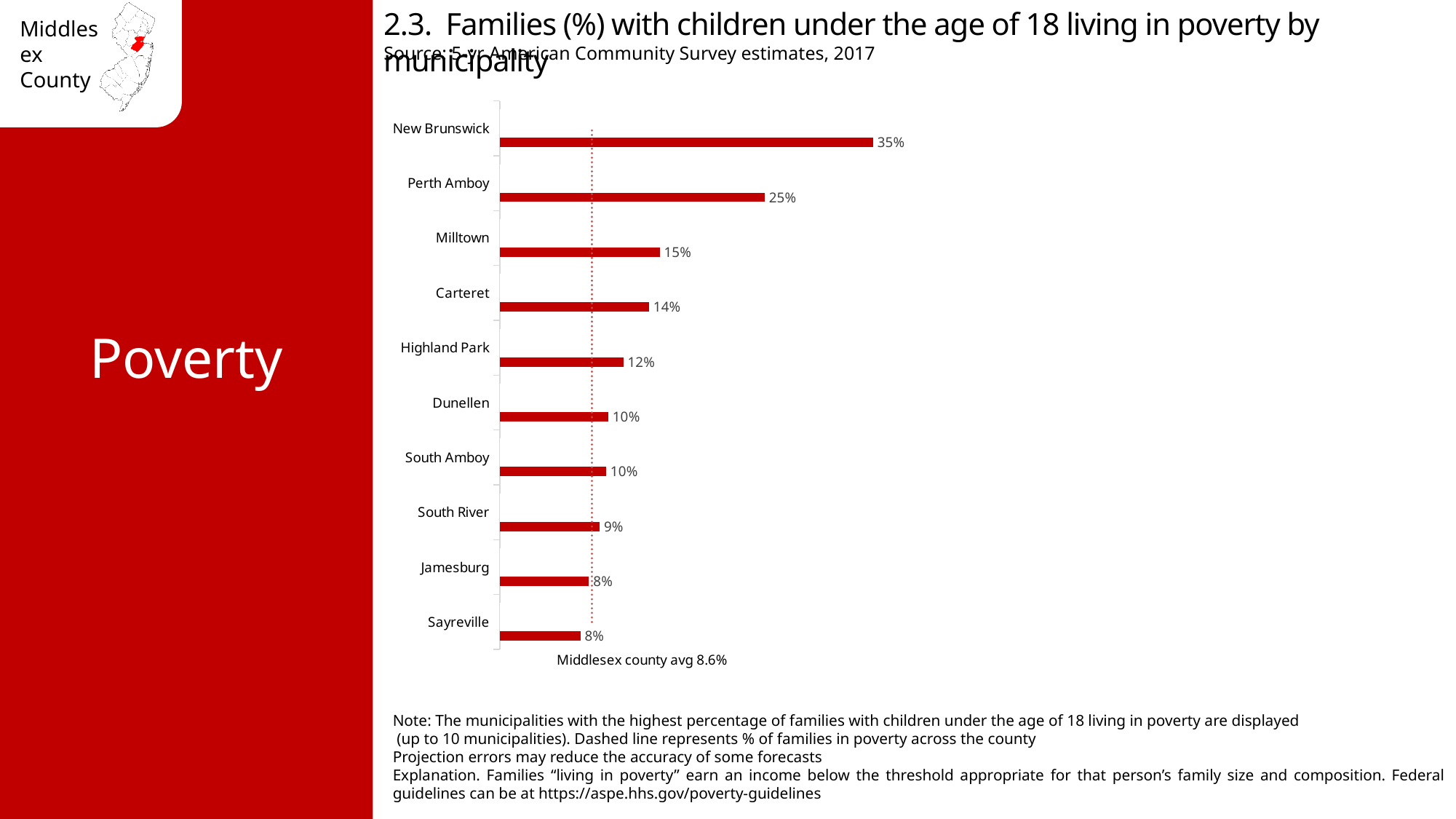
What is the value shown for Carteret? 14% What is the value shown for Perth Amboy? 25% Which has a higher value, Perth Amboy or Milltown? Perth Amboy What is the difference between the values for Milltown and Carteret? 1% What percentage of families with children under 18 are living in poverty in New Brunswick? 35% What is the Middlesex county average shown by the dashed line? 8.6% What kind of chart is shown on the slide? Bar chart What is the value shown for Highland Park? 12% What is the difference between the values for New Brunswick and Perth Amboy? 10% Which municipality has the highest percentage of families with children under 18 living in poverty? New Brunswick What is the source of the data shown in the chart? 5-yr American Community Survey estimates, 2017 How many municipalities are shown in the chart? 10